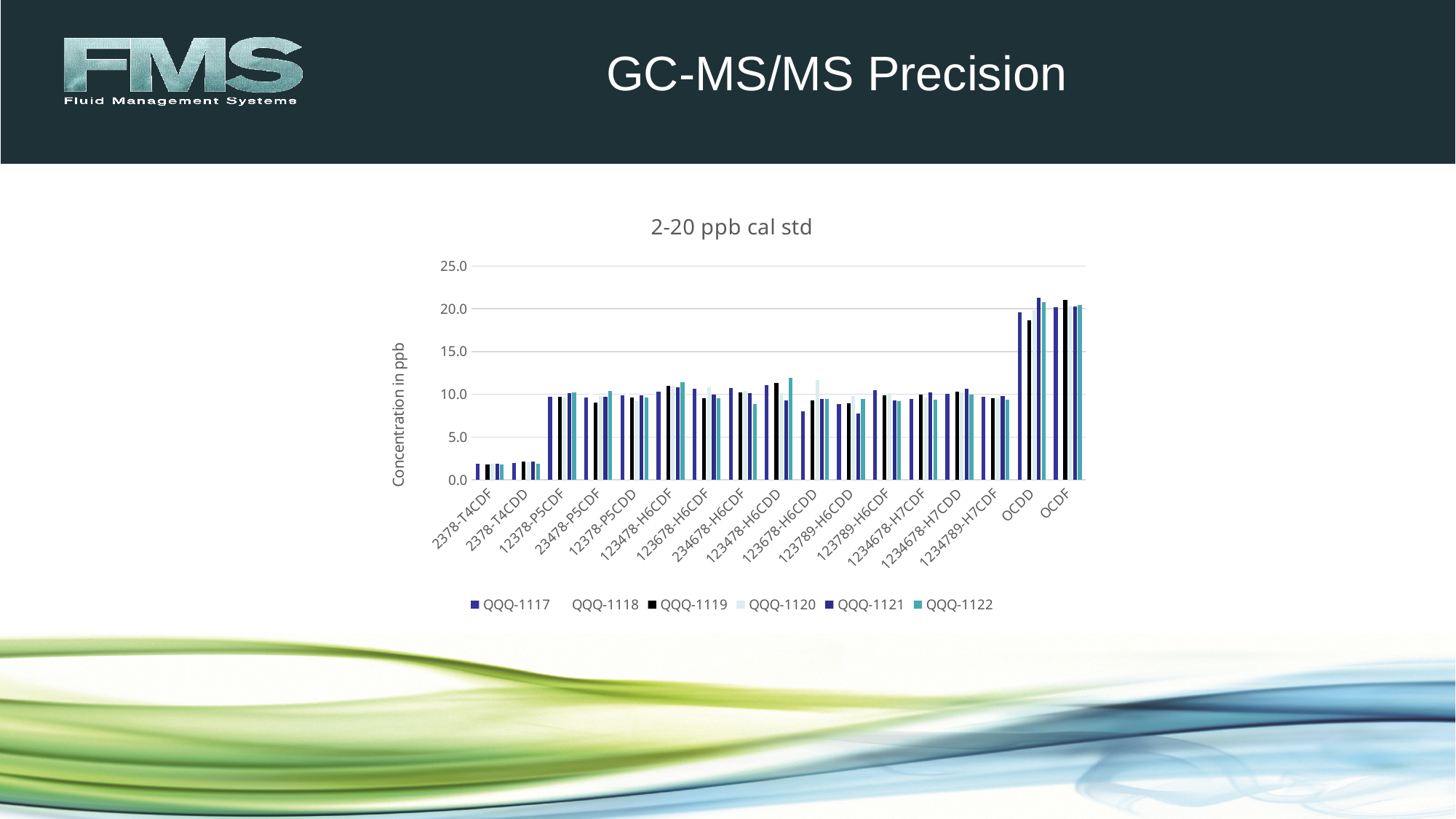
How many series does the legend of the chart list? 6 Is the value for 2378-T4CDF in the QQQ-1117 series greater or less than 5.0? less How many categories are shown along the x axis of the chart? 17 For the QQQ-1119 series, which is larger: the value for 2378-T4CDF or the value for 123478-H6CDF? 123478-H6CDF Is the value for OCDF in the QQQ-1122 series greater or less than 15.0? greater Is the value for 12378-P5CDF in the QQQ-1119 series greater or less than 5.0? greater For the QQQ-1117 series, which is larger: the value for 2378-T4CDD or the value for OCDD? OCDD What is the title of the chart? 2-20 ppb cal std What is the label on the vertical axis of the chart? Concentration in ppb What kind of chart is shown on the slide? bar chart